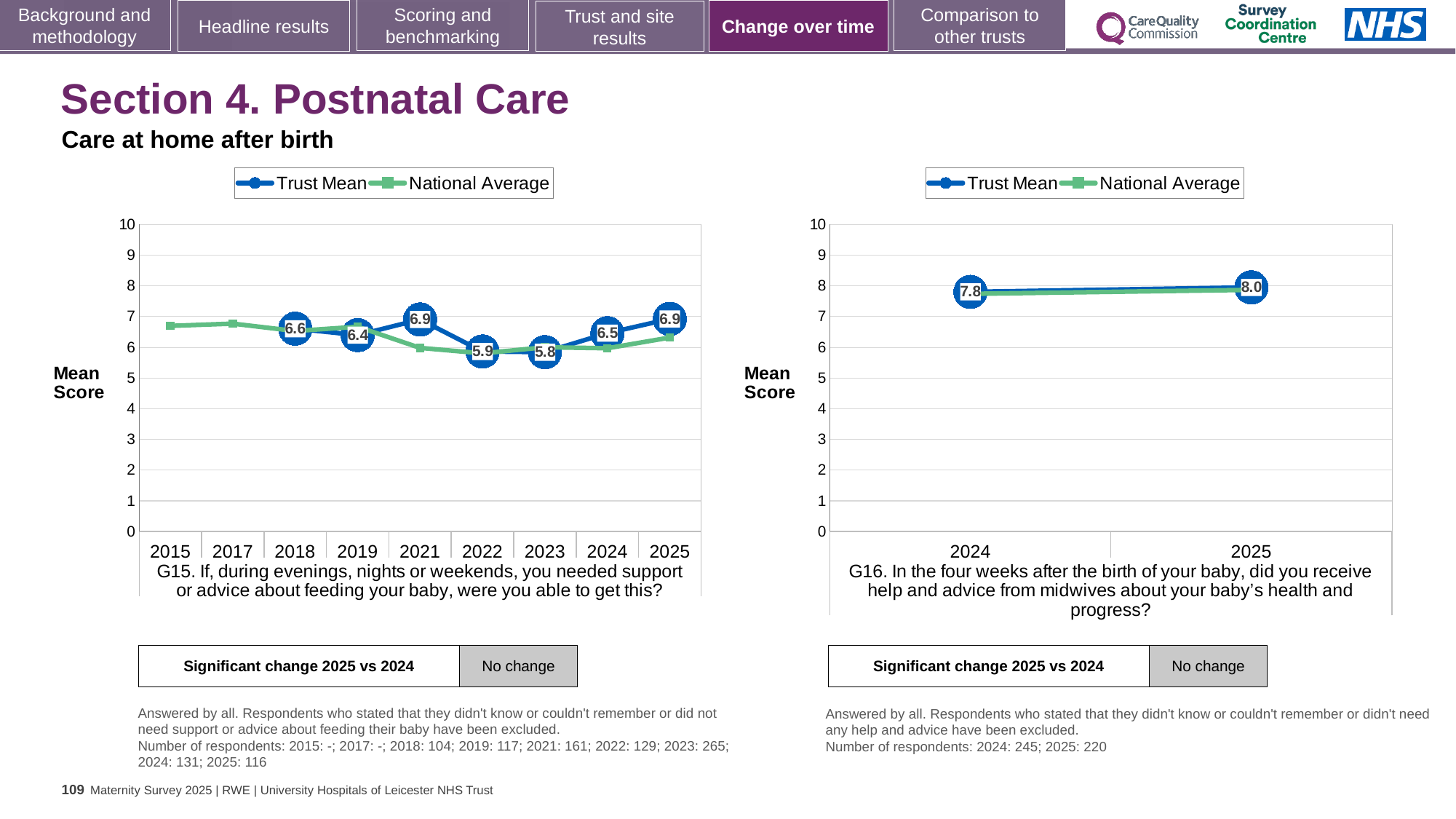
In the G16 chart on the right, does the Trust Mean rise or fall from 2024 to 2025? Rise In the G16 chart on the right, what is the Trust Mean for 2024? 7.8 In the G15 chart on the left, is the National Average for 2015 greater or less than 6? greater How many series does the legend of the G16 chart on the right list? 2 How many years are shown on the x axis of the G15 chart on the left? 9 In the G16 chart on the right, what is the difference between the Trust Mean for 2025 and 2024? 0.2 In the G15 chart on the left, is the Trust Mean higher in 2021 or in 2022? 2021 In the G15 chart on the left, what is the difference between the Trust Mean for 2025 and 2024? 0.4 In the G15 chart on the left, which year has the lowest Trust Mean? 2023 What kind of chart is the G16 chart on the right? Line chart In the G15 chart on the left, what is the Trust Mean for 2025? 6.9 In the G15 chart on the left, what is the Trust Mean for 2023? 5.8